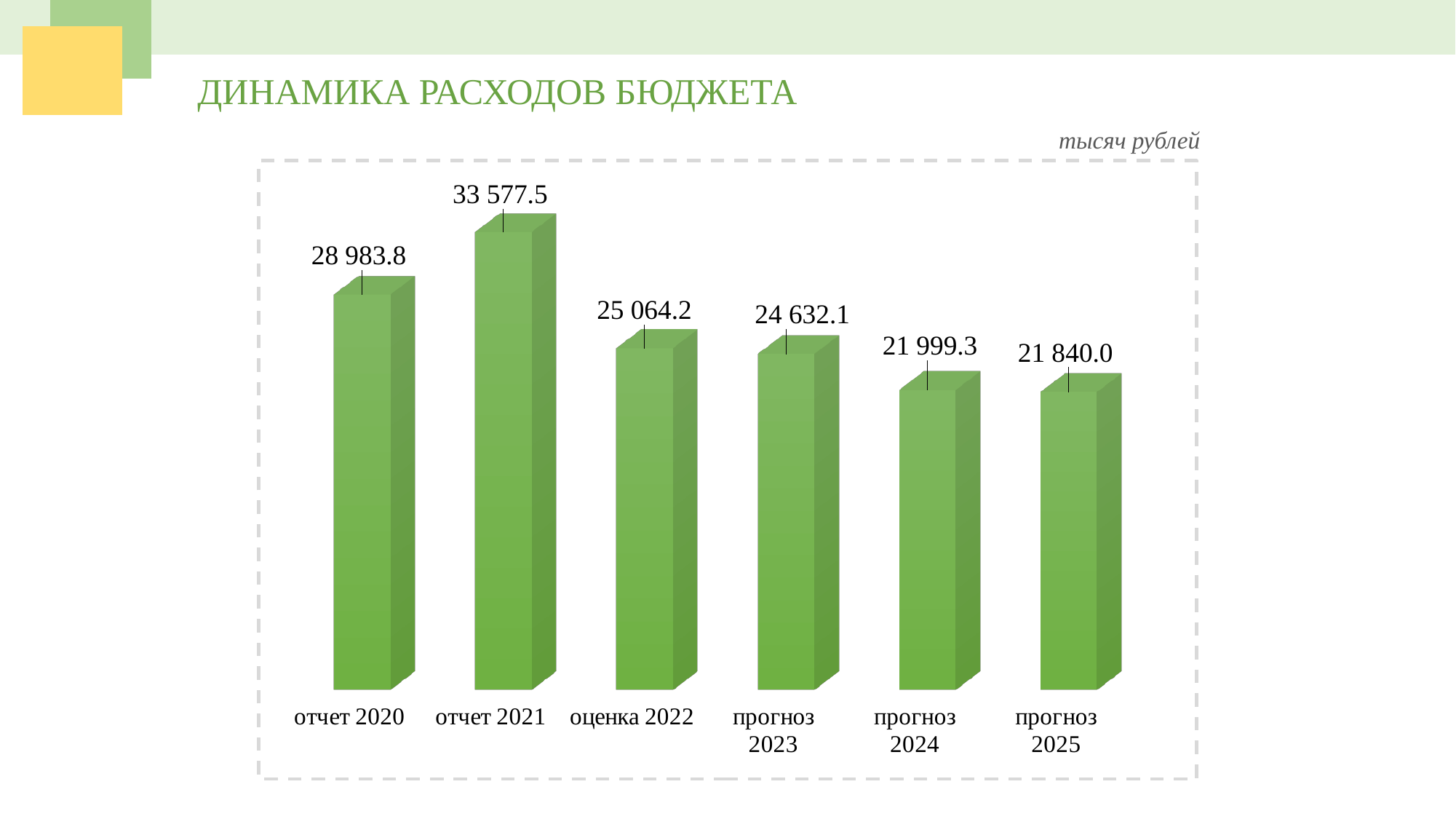
What kind of chart is shown on the slide? bar chart What is the value for прогноз 2025? 21 840.0 Do the values rise or fall from отчет 2021 to прогноз 2025? fall What is the value for отчет 2020? 28 983.8 What is the difference between the values for отчет 2021 and отчет 2020? 4 593.7 How many categories are shown on the chart? 6 Which is larger, the value for прогноз 2024 or прогноз 2025? прогноз 2024 What is the value for прогноз 2023? 24 632.1 What is the difference between the values for оценка 2022 and прогноз 2023? 432.1 Which category has the highest value? отчет 2021 What unit is stated above the chart? тысяч рублей Which category has the lowest value? прогноз 2025